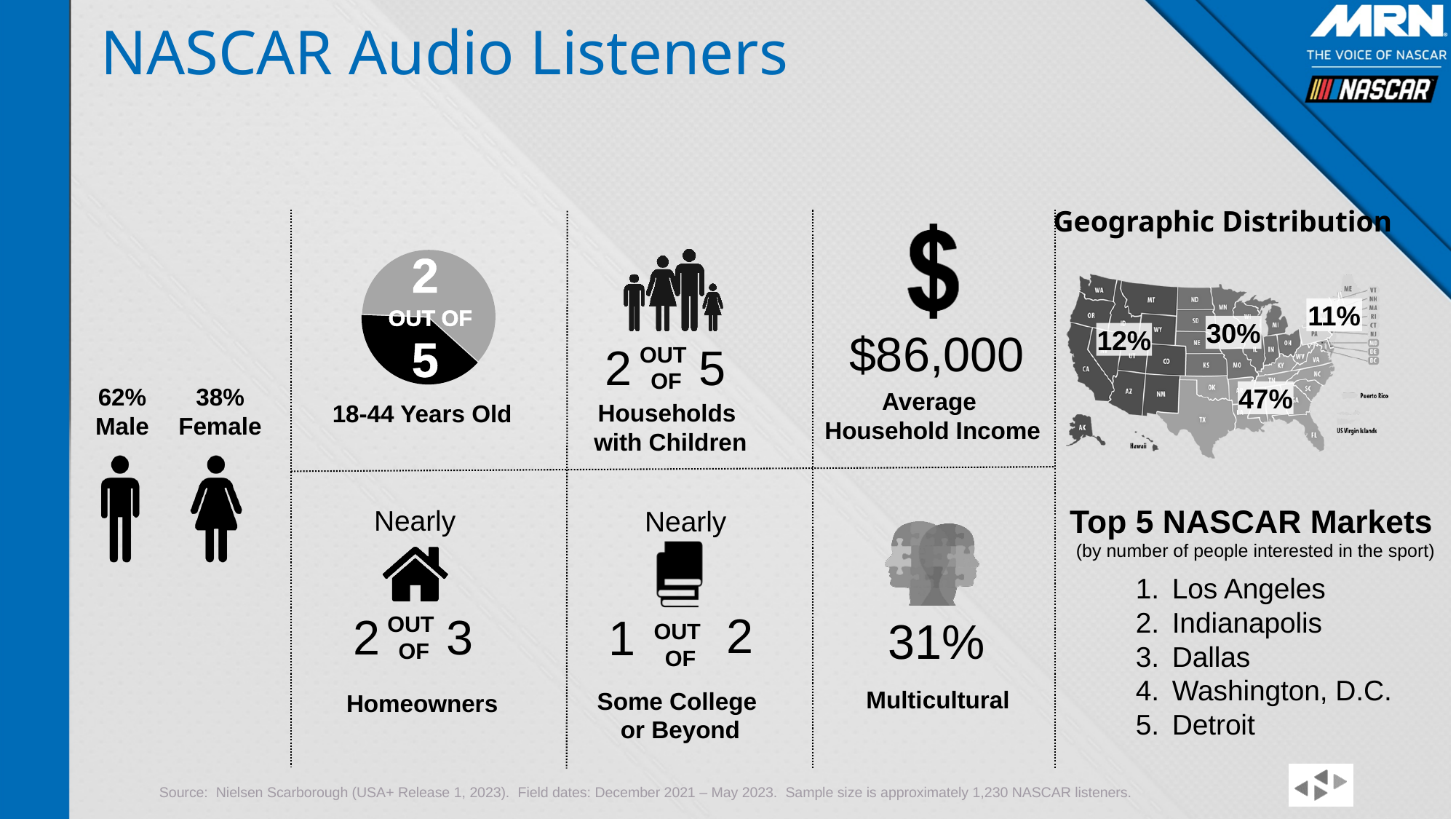
What kind of chart is used to show the share of listeners aged 18-44 years old? pie chart According to the pie chart, how many out of 5 NASCAR audio listeners are 18-44 years old? 2 out of 5 How many percentage values are labelled on the Geographic Distribution map? 4 In the Geographic Distribution map, which region has the highest percentage of listeners? the southeastern region (47%) In the Geographic Distribution map, what is the difference between the southern region's 47% and the Midwest's 30%? 17% In the Geographic Distribution map, which is larger: the western region's share or the northeastern region's share? western region (12%) What is the title of the map on the slide? Geographic Distribution In the Geographic Distribution map, what is the lowest percentage shown? 11% In the Geographic Distribution map, what percentage is shown for the Midwest region? 30% In the Geographic Distribution map, what percentage is shown for the western region? 12% What percentage of NASCAR audio listeners are male? 62% How many slices does the 18-44 Years Old pie chart have? 2